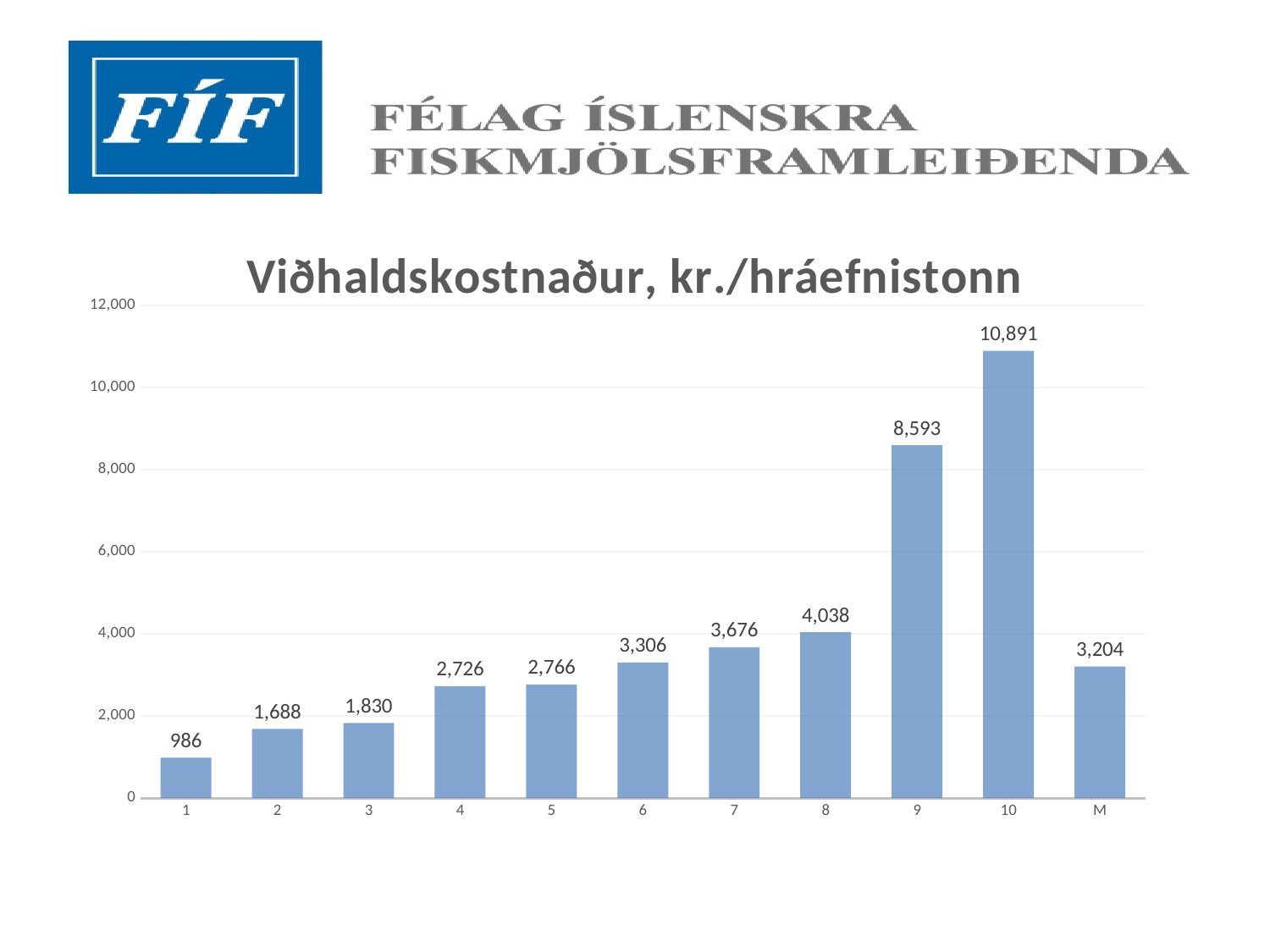
What kind of chart is this? bar chart What is the difference between the values for category 10 and category 9? 2,298 Is the value for category 9 greater or less than 8,000? greater How many categories are shown on the x axis? 11 What is the value for category 1? 986 Which category has the highest value? 10 What is the title of the chart? Viðhaldskostnaður, kr./hráefnistonn What is the value for category 10? 10,891 Do the values rise or fall from category 1 to category 10? rise What is the value for category M? 3,204 Which is larger, the value for category 8 or the value for category M? 8 Which category has the lowest value? 1